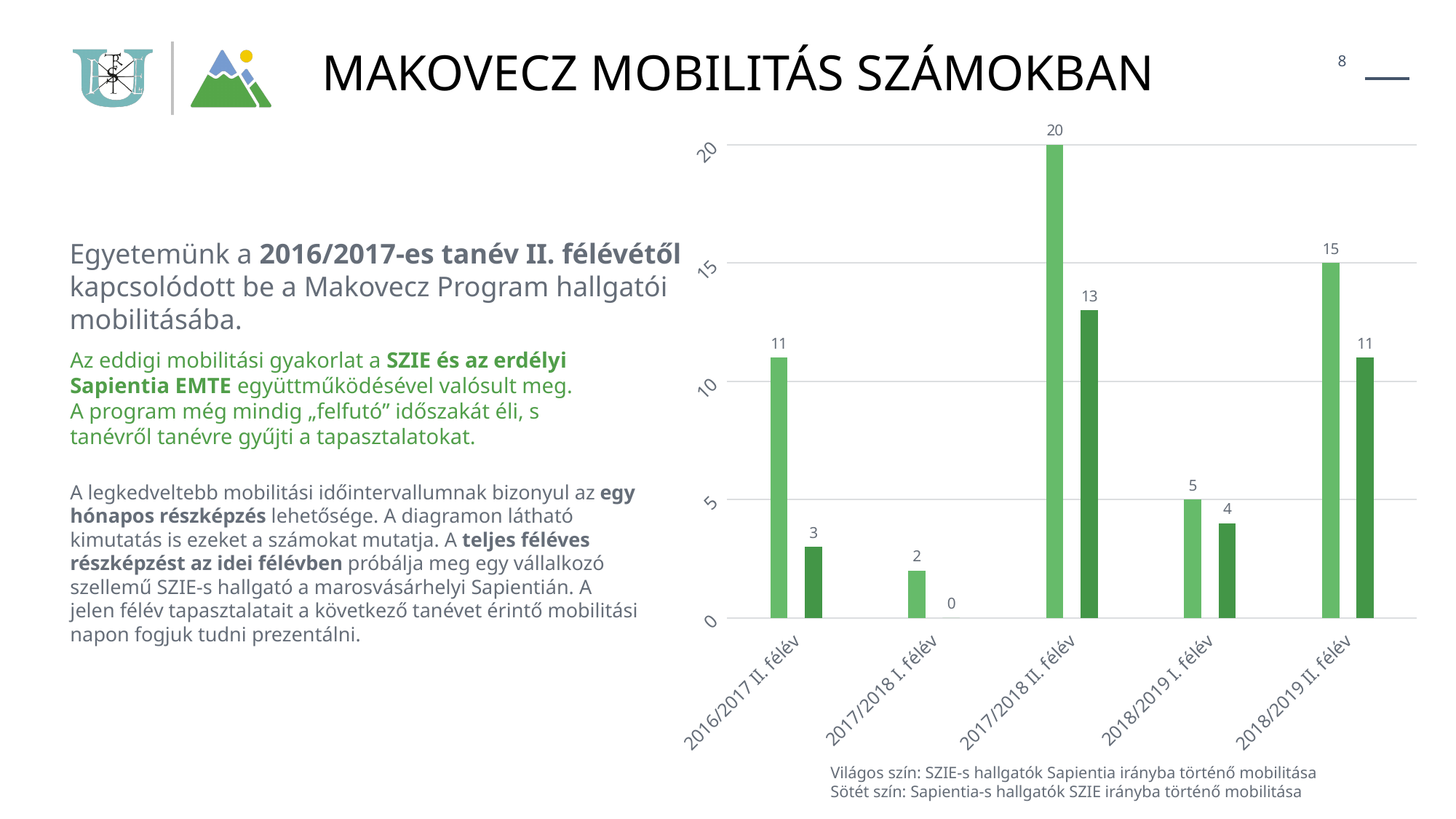
What is the value of the light-coloured bar for 2018/2019 II. félév? 15 What is the value of the dark-coloured bar for 2017/2018 I. félév? 0 What type of chart is shown on the slide? bar chart How many semesters are shown on the x axis of the chart? 5 According to the caption, what does the dark colour represent in the chart? Sapientia-s hallgatók SZIE irányba történő mobilitása Which is larger for 2018/2019 I. félév: the light-coloured bar or the dark-coloured bar? the light-coloured bar What is the difference between the light and dark bars for 2017/2018 II. félév? 7 Which semester has the highest value for the light-coloured bars (SZIE students to Sapientia)? 2017/2018 II. félév What is the value of the light-coloured bar (SZIE students to Sapientia) for 2017/2018 II. félév? 20 What is the value of the dark-coloured bar (Sapientia students to SZIE) for 2016/2017 II. félév? 3 Which semester has the lowest value for the dark-coloured bars (Sapientia students to SZIE)? 2017/2018 I. félév How many data series are plotted in the chart? 2